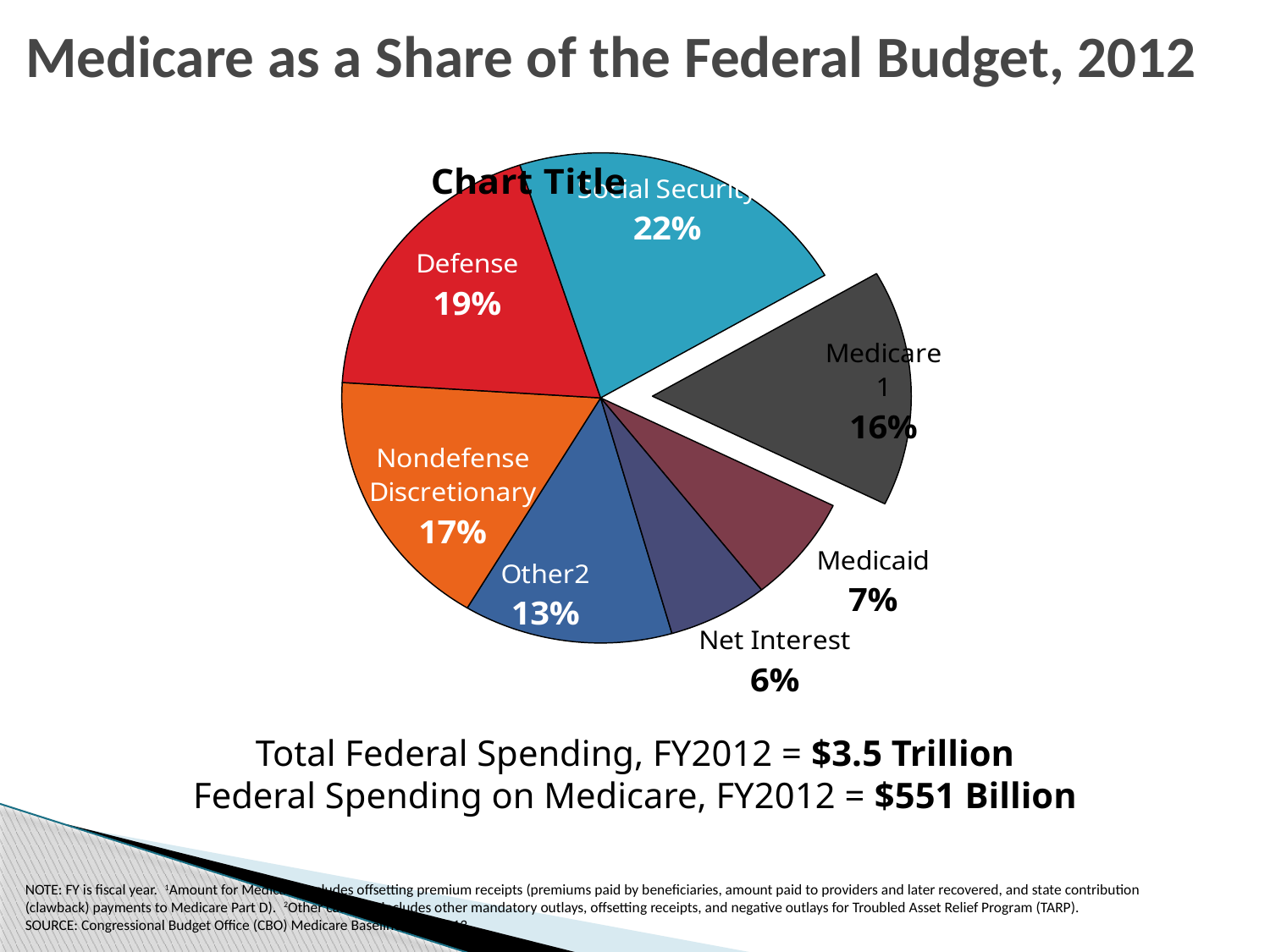
What is the difference in percentage points between Defense and Medicaid? 12 How many slices does the pie chart have? 7 Which slice is pulled out (exploded) from the rest of the pie? Medicare Which slice of the pie chart is the largest? Social Security Which is larger, the Defense slice or the Medicare slice? Defense What is the combined share of Medicare and Medicaid? 23% What kind of chart is shown on the slide? Pie chart What percentage is shown for Medicare in the pie chart? 16% What percentage is shown for Net Interest? 6% Which slice of the pie chart is the smallest? Net Interest What percentage is shown for Nondefense Discretionary spending? 17% What share of the federal budget does Social Security represent in the pie chart? 22%